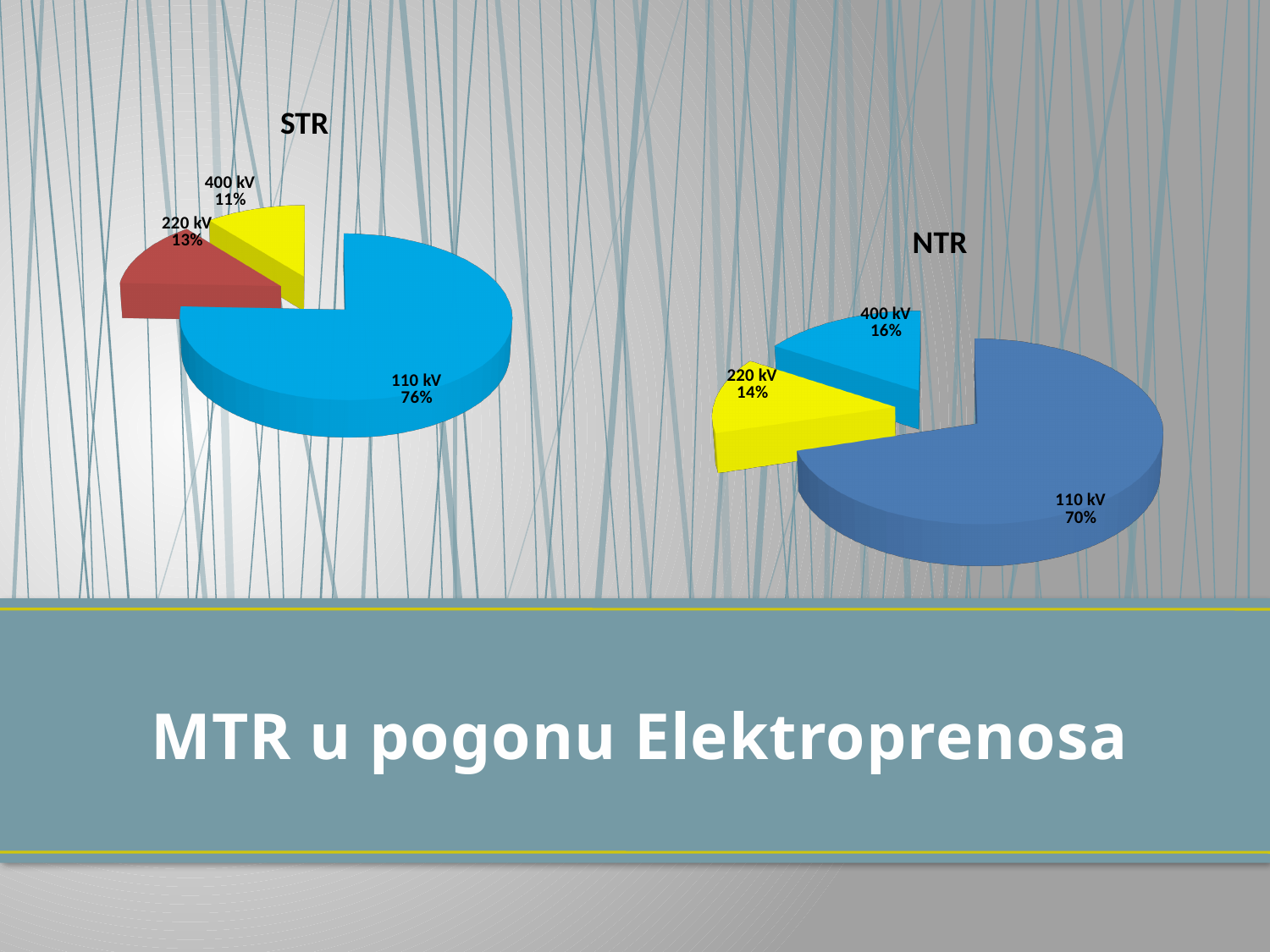
In the NTR chart, which category has the smallest slice? 220 kV In the STR chart, what share does the 110 kV slice have? 76% In the STR chart, what share does the 220 kV slice have? 13% In the STR chart, what share does the 400 kV slice have? 11% In the STR chart, which category has the largest slice? 110 kV In the NTR chart, what is the difference in percentage points between the 110 kV and 400 kV slices? 54 How many slices does the NTR chart have? 3 In the STR chart, which is larger, the 220 kV slice or the 400 kV slice? 220 kV What kind of chart is the STR chart? Pie chart